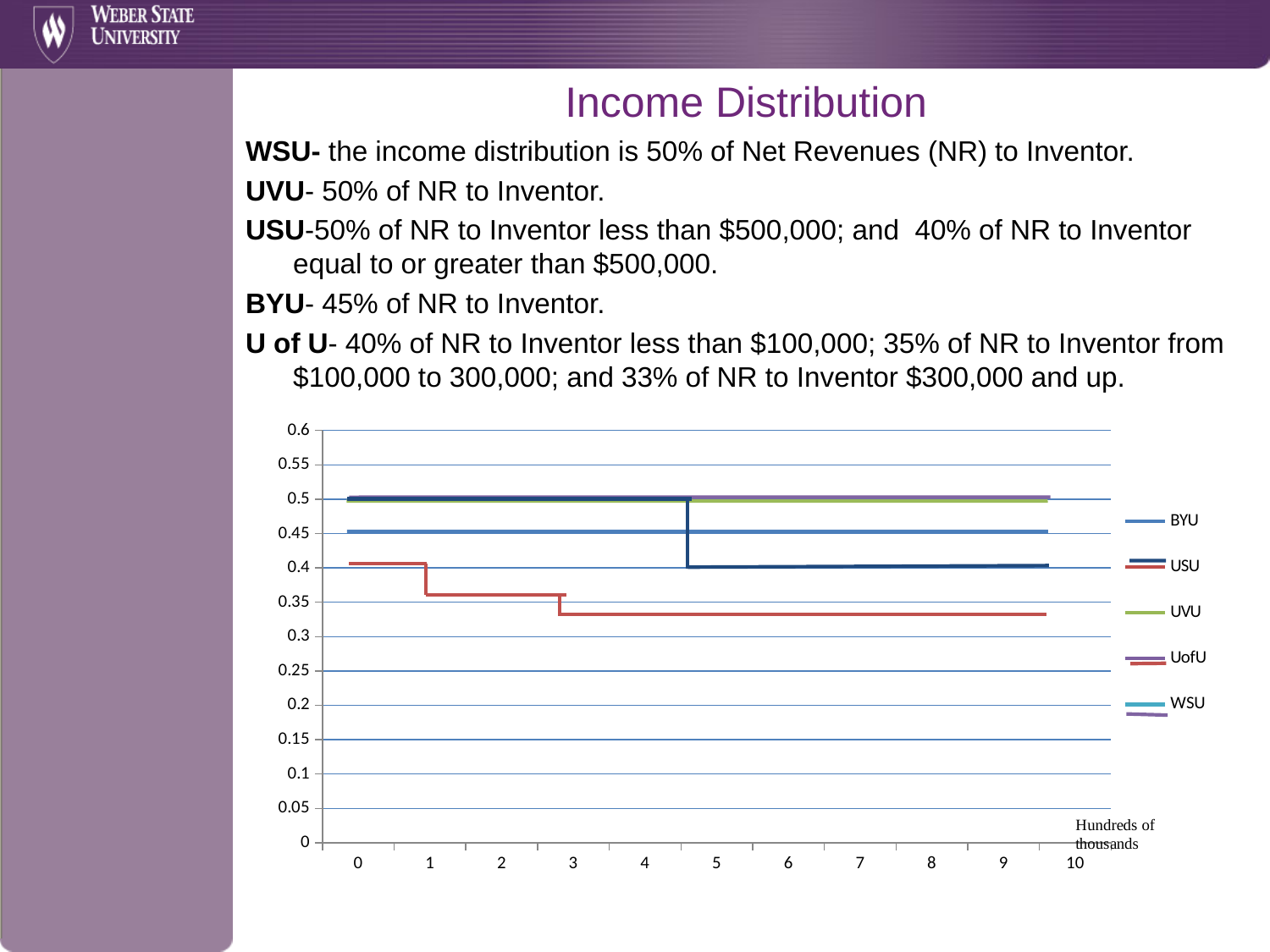
What value does the UVU line hold across the chart? 0.5 Does the USU line rise or fall as x increases? fall What value does the USU line hold at x = 8? 0.4 What kind of chart is shown on the slide? line chart What value does the BYU line hold across the chart? 0.45 Which series is listed first in the legend? BYU What value does the UofU line hold at x = 2? 0.35 Which series has the lowest value at x = 8? UofU What is the label shown at the right end of the x axis? Hundreds of thousands How many series does the chart's legend list? 5 Is the value of the UofU line at x = 8 greater or less than 0.35? less At x = 8, which is larger: the BYU value or the USU value? BYU